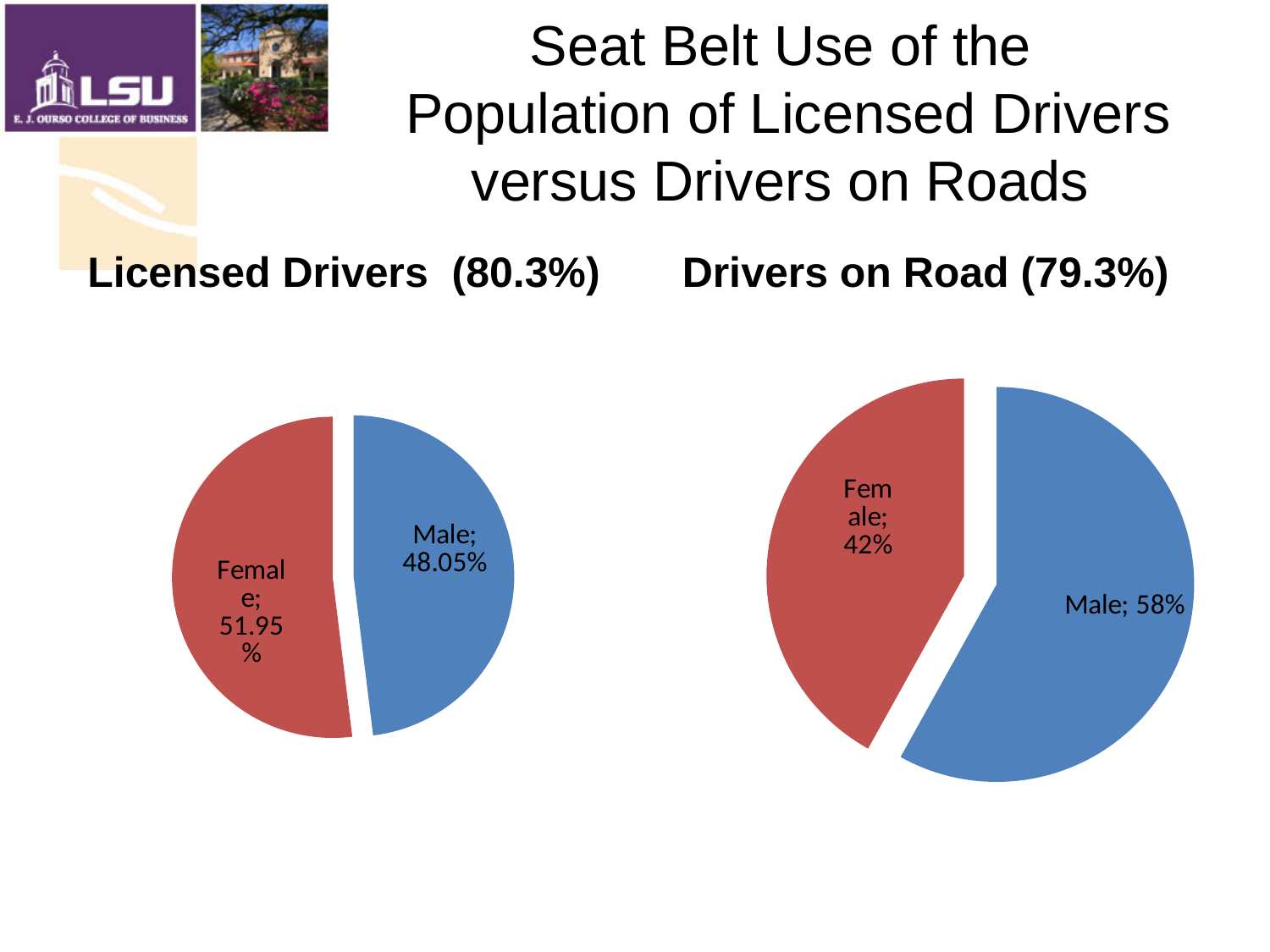
In the Drivers on Road pie chart, which is larger, Male or Female? Male In the Licensed Drivers pie chart, what is the value for Male? 48.05% In the Drivers on Road pie chart, what is the value for Female? 42% In the Drivers on Road pie chart, what colour is the Male slice? Blue How many slices does the Licensed Drivers pie chart have? 2 In the Licensed Drivers pie chart, what is the value for Female? 51.95% In the Licensed Drivers pie chart, which slice is the smallest? Male What type of chart is the Drivers on Road chart? Pie chart In the Drivers on Road pie chart, what is the value for Male? 58% In the Drivers on Road pie chart, which slice is the largest? Male In the Licensed Drivers pie chart, what is the difference between the Female and Male values? 3.9% In the Drivers on Road pie chart, what is the difference between the Male and Female values? 16%